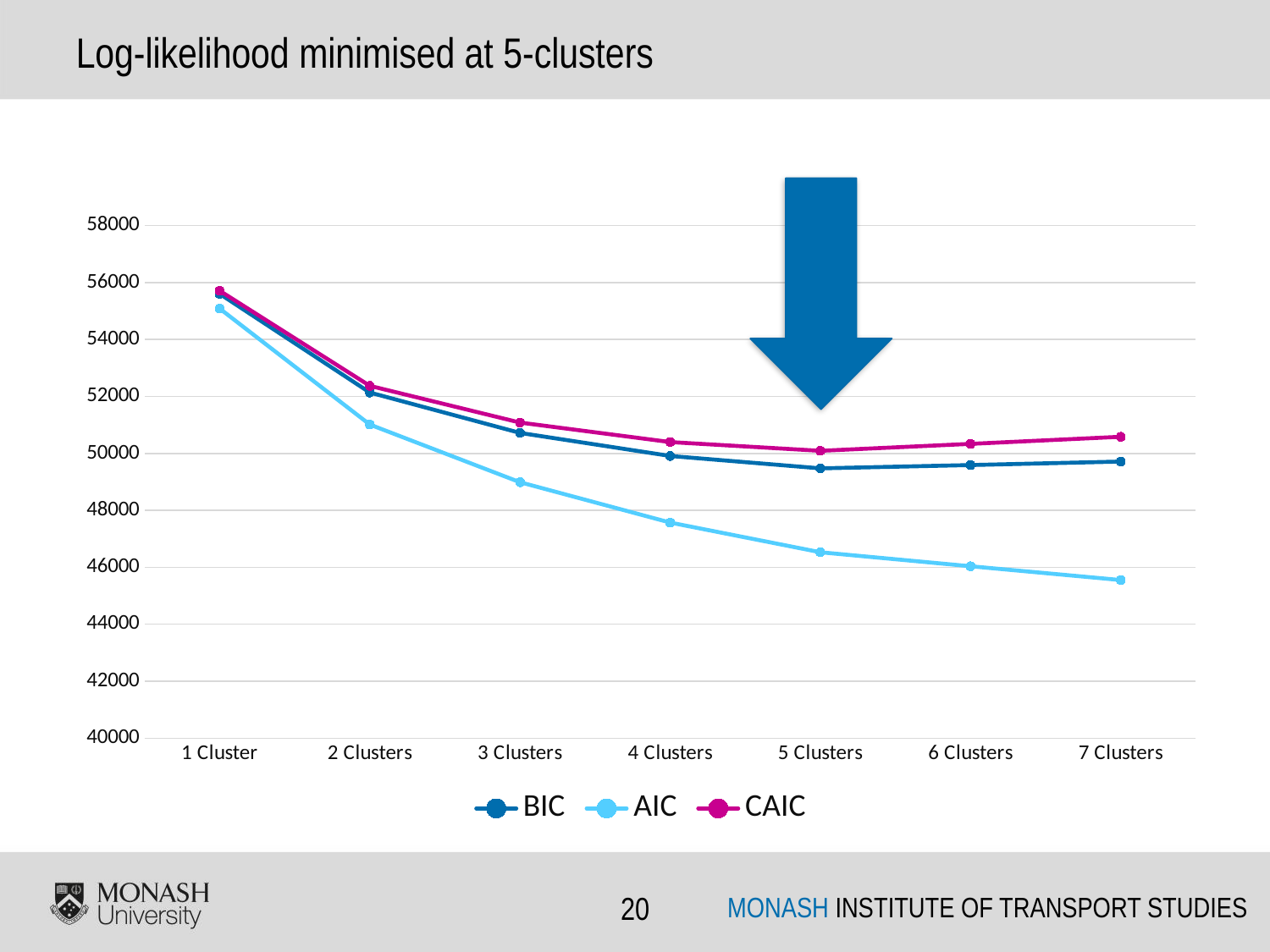
Does the AIC series rise or fall as the number of clusters increases from 1 to 7? fall How many series does the legend list? 3 Is the value for AIC at 4 Clusters greater or less than 48000? less At which cluster count is the CAIC series highest? 1 Cluster Is the value for BIC at 5 Clusters greater or less than 50000? less Is the value for AIC at 7 Clusters greater or less than 46000? less How many cluster categories are plotted along the x axis? 7 What kind of chart is shown on the slide? line chart Which series are listed in the legend? BIC, AIC, CAIC What is the title of the slide? Log-likelihood minimised at 5-clusters At which cluster count is the BIC series lowest? 5 Clusters At which cluster count is the AIC series lowest? 7 Clusters